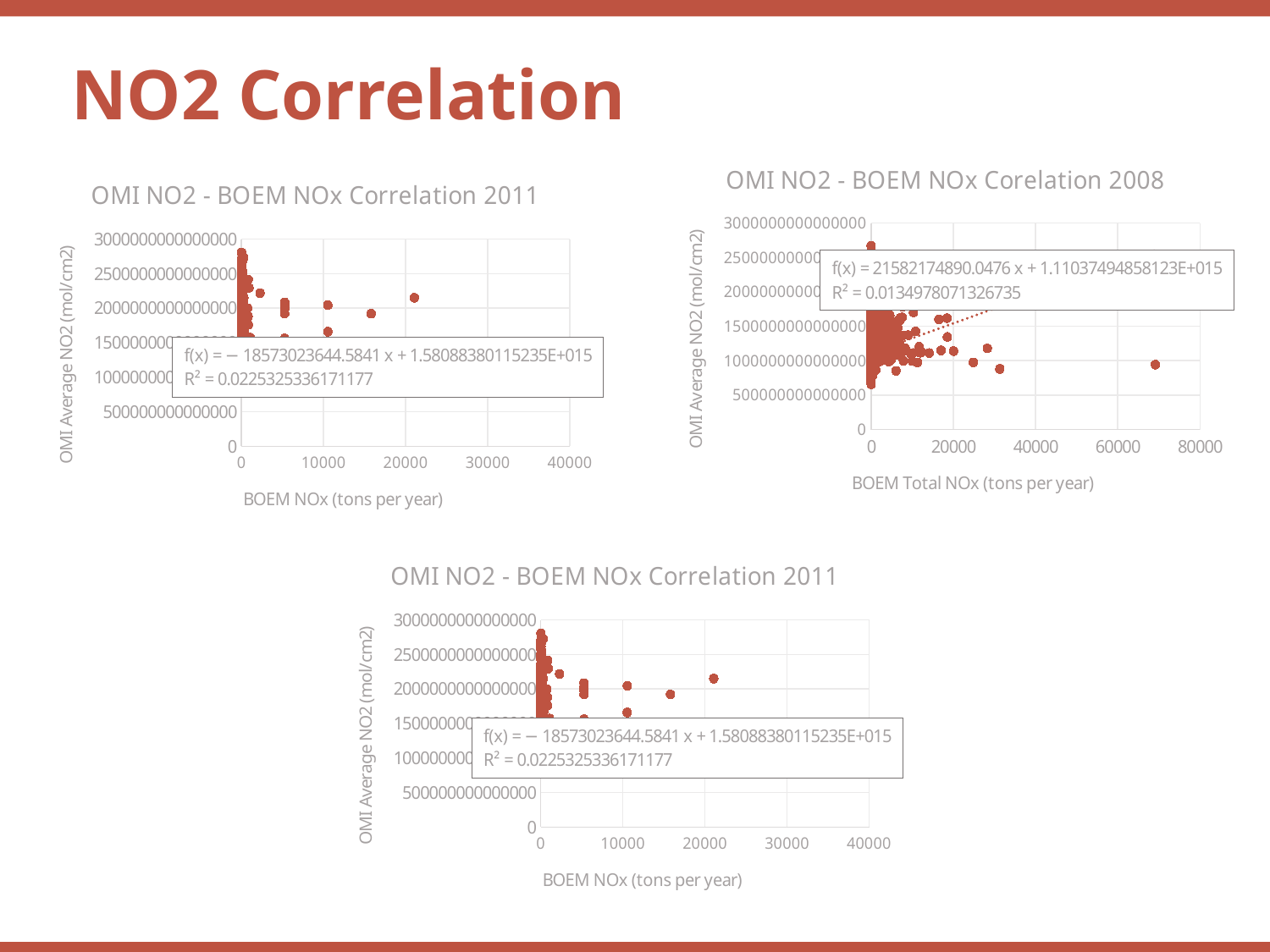
What kind of chart is the top-left chart titled 'OMI NO2 - BOEM NOx Correlation 2011'? Scatter chart What is the R² value shown on the top-left chart 'OMI NO2 - BOEM NOx Correlation 2011'? 0.0225325336171177 What is the y-axis label of the bottom chart 'OMI NO2 - BOEM NOx Correlation 2011'? OMI Average NO2 (mol/cm2) What is the R² value shown on the top-right chart 'OMI NO2 - BOEM NOx Corelation 2008'? 0.0134978071326735 What is the x-axis label of the top-right chart 'OMI NO2 - BOEM NOx Corelation 2008'? BOEM Total NOx (tons per year) In the top-right chart 'OMI NO2 - BOEM NOx Corelation 2008', is the x value of the rightmost data point greater or less than 60000? greater What is the highest x-axis tick value shown on the top-right chart 'OMI NO2 - BOEM NOx Corelation 2008'? 80000 In the bottom chart 'OMI NO2 - BOEM NOx Correlation 2011', is the y value of the rightmost data point greater or less than 2000000000000000? greater How many charts are shown on the slide? 3 In the bottom chart 'OMI NO2 - BOEM NOx Correlation 2011', is the slope of the fitted trendline positive or negative? Negative In the top-right chart 'OMI NO2 - BOEM NOx Corelation 2008', is the slope of the fitted trendline positive or negative? Positive What is the highest x-axis tick value shown on the top-left chart 'OMI NO2 - BOEM NOx Correlation 2011'? 40000